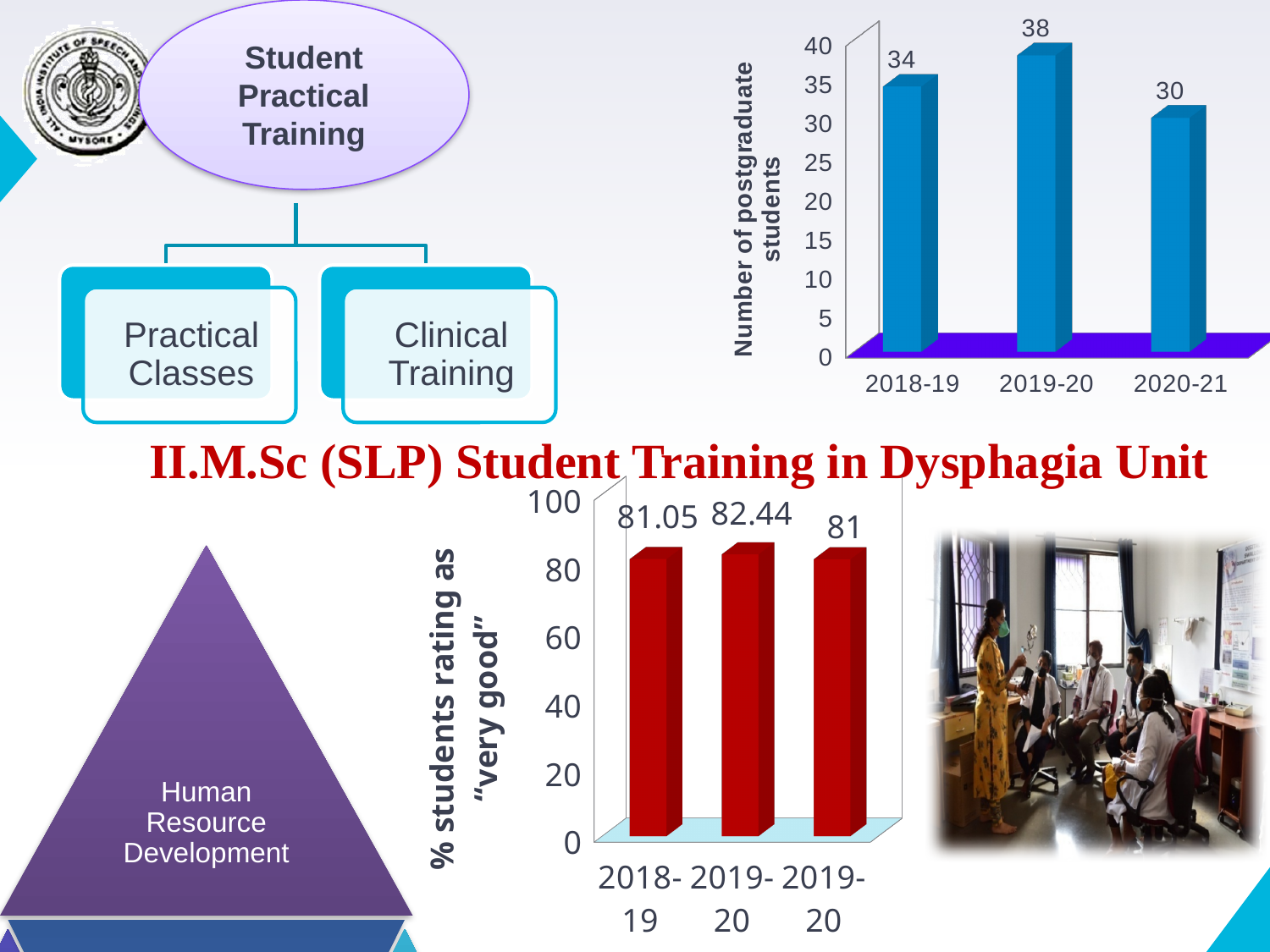
What kind of chart is the top-right chart of number of postgraduate students? Bar chart In the top-right chart of number of postgraduate students, what is the value for 2020-21? 30 In the bottom chart of % students rating as 'very good', what is the value of the third (rightmost) bar? 81 In the bottom chart of % students rating as 'very good', what is the value of the first bar (2018-19)? 81.05 In the top-right chart of number of postgraduate students, how many years are shown on the x axis? 3 In the top-right chart of number of postgraduate students, which year has the lowest value? 2020-21 In the bottom chart of % students rating as 'very good', what is the value of the second bar? 82.44 In the bottom chart of % students rating as 'very good', is the value of the first bar greater or less than 80? greater In the bottom chart of % students rating as 'very good', what is the difference between the second bar and the first bar? 1.39 In the top-right chart of number of postgraduate students, what is the difference between 2019-20 and 2020-21? 8 In the top-right chart of number of postgraduate students, what is the value for 2018-19? 34 In the top-right chart of number of postgraduate students, which year has the highest value? 2019-20